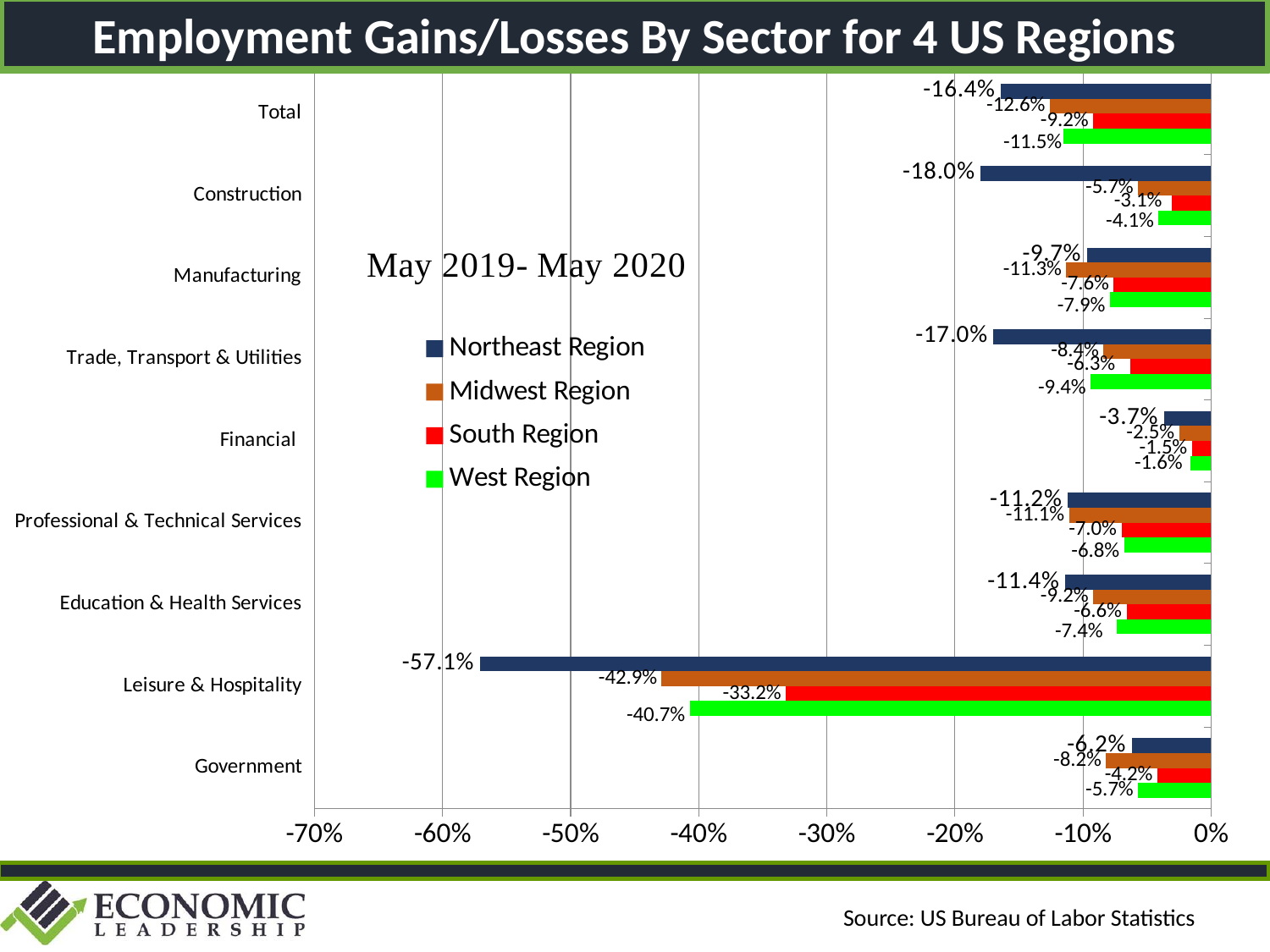
What type of chart is shown on the slide? Bar chart How many sectors (categories) are shown on the chart? 9 How many regions does the legend list? 4 Which sector shows the smallest employment loss for the South Region? Financial What is the value for the Northeast Region in Leisure & Hospitality? -57.1% What is the value for the West Region in Construction? -4.1% What time period does the chart cover, according to the text on the chart? May 2019 - May 2020 What is the difference between the Northeast Region and the South Region values in Leisure & Hospitality? 23.9 percentage points What is the value for the Midwest Region in Government? -8.2% What is the value for the South Region in Total? -9.2% In Construction, which region has the larger employment loss, the Northeast Region or the Midwest Region? Northeast Region Which sector shows the largest employment loss for the Northeast Region? Leisure & Hospitality